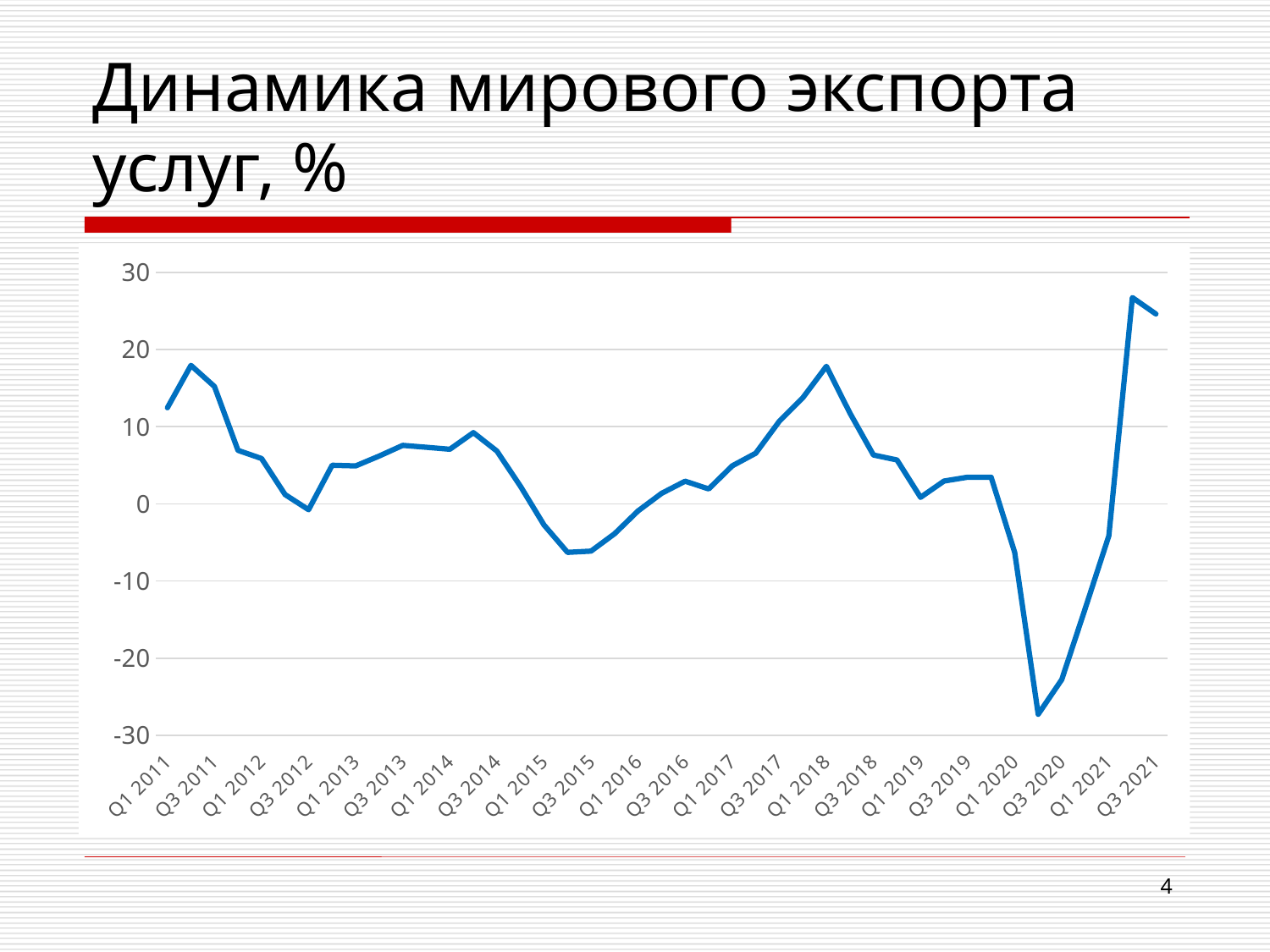
Is the value for Q1 2011 greater or less than 10? greater Which quarter has the lowest value on the chart? Q2 2020 Is the value for Q3 2015 greater or less than 0? less Does the line rise or fall between Q3 2020 and Q1 2021? rise What is the title of the chart on the slide? Динамика мирового экспорта услуг, % What kind of chart is shown on the slide? line chart Is the value for Q1 2018 greater or less than 20? less Which is higher, the value for Q1 2018 or the value for Q3 2021? Q3 2021 Which is higher, the value for Q3 2011 or the value for Q3 2012? Q3 2011